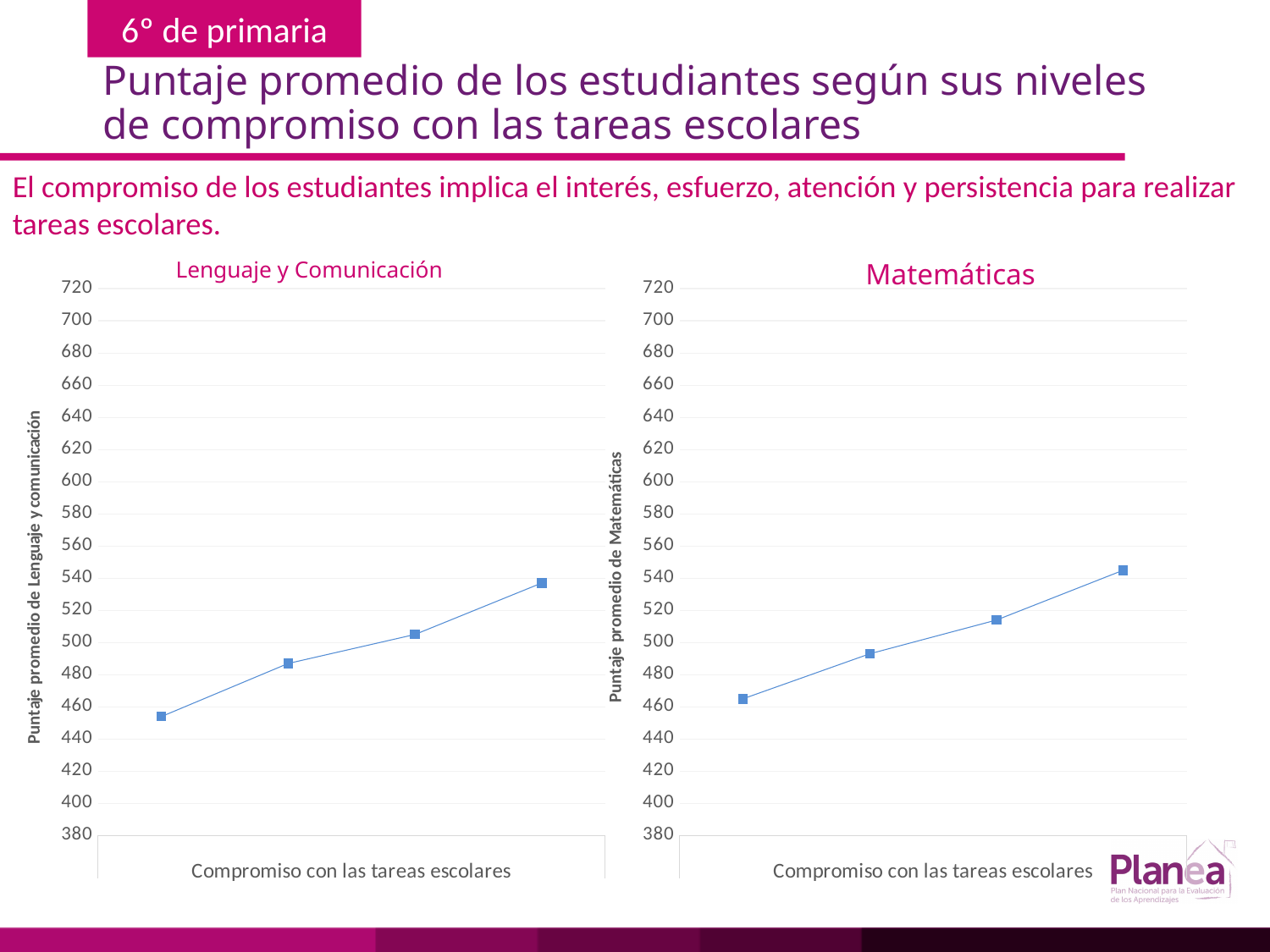
In the Matemáticas chart, is the value of the rightmost point greater or less than 520? greater In the Matemáticas chart, do the values rise or fall from left to right along the x axis? rise What kind of chart is the Lenguaje y Comunicación chart? line chart In the Lenguaje y Comunicación chart, is the value of the rightmost point greater or less than 520? greater In the Matemáticas chart, is the value of the leftmost point greater or less than 480? less What is the y-axis label of the Matemáticas chart? Puntaje promedio de Matemáticas In the Lenguaje y Comunicación chart, do the values rise or fall from left to right along the x axis? rise How many data points are plotted in the Matemáticas chart? 4 What is the x-axis label of the Lenguaje y Comunicación chart? Compromiso con las tareas escolares How many data points are plotted in the Lenguaje y Comunicación chart? 4 In the Matemáticas chart, which point has the highest value, the leftmost or the rightmost? the rightmost